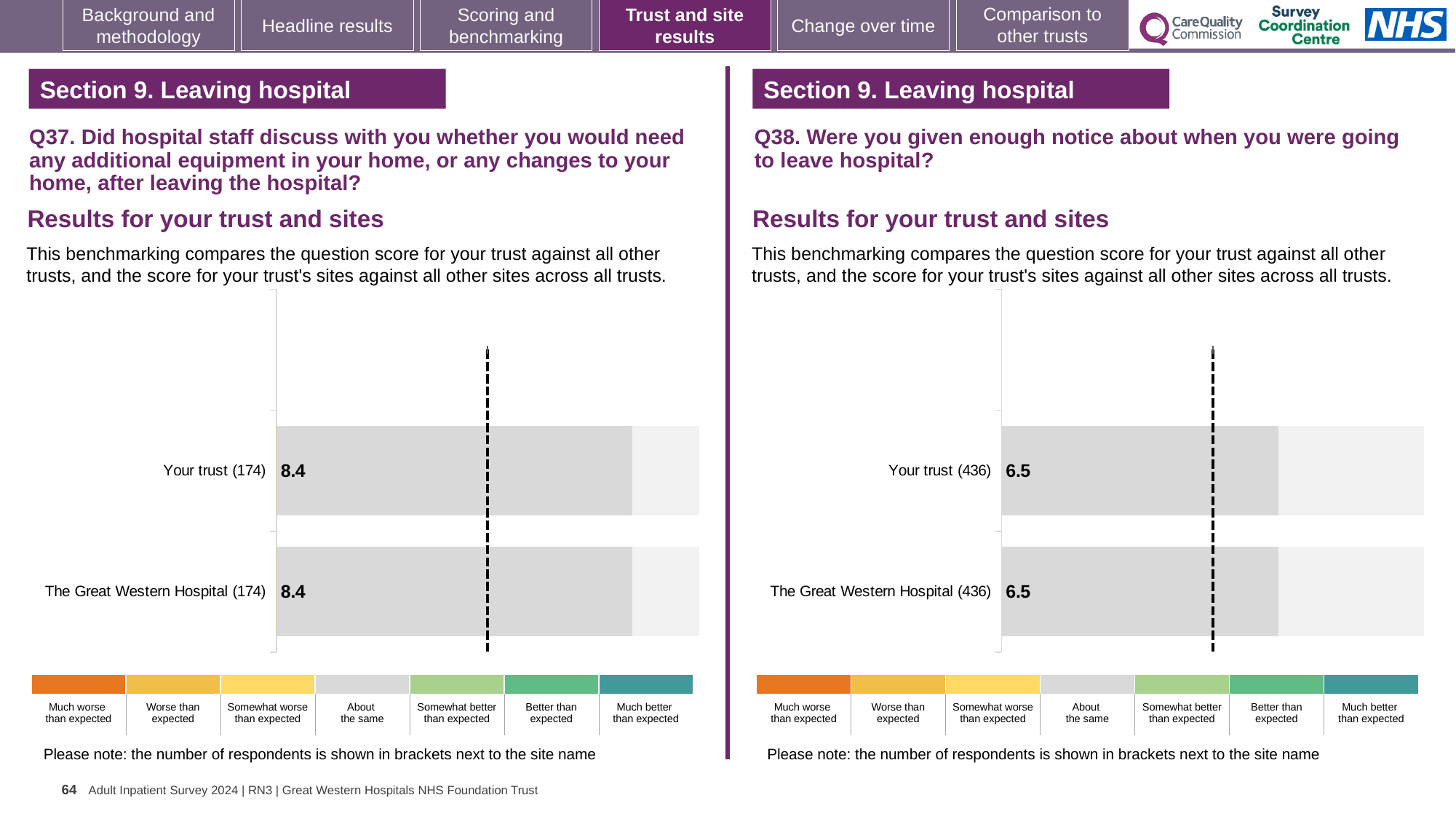
What kind of chart is used in the Q37 chart on the left? Bar chart In the Q37 chart on the left, what is the difference between the score for Your trust and the score for The Great Western Hospital? 0 In the Q37 chart on the left, what is the score for The Great Western Hospital? 8.4 In the Q38 chart on the right, how many respondents are shown in brackets for The Great Western Hospital? 436 In the Q38 chart on the right, which category label appears on the bottom bar? The Great Western Hospital (436) Which chart on the slide has the higher score for Your trust, the Q37 chart on the left or the Q38 chart on the right? The Q37 chart on the left In the Q37 chart on the left, what is the score for Your trust? 8.4 In the Q38 chart on the right, what is the score for The Great Western Hospital? 6.5 In the Q37 chart on the left, how many respondents are shown in brackets for Your trust? 174 In the Q38 chart on the right, what is the score for Your trust? 6.5 How many bars are plotted in the Q38 chart on the right? 2 How many categories does the colour key below the Q37 chart on the left list? 7